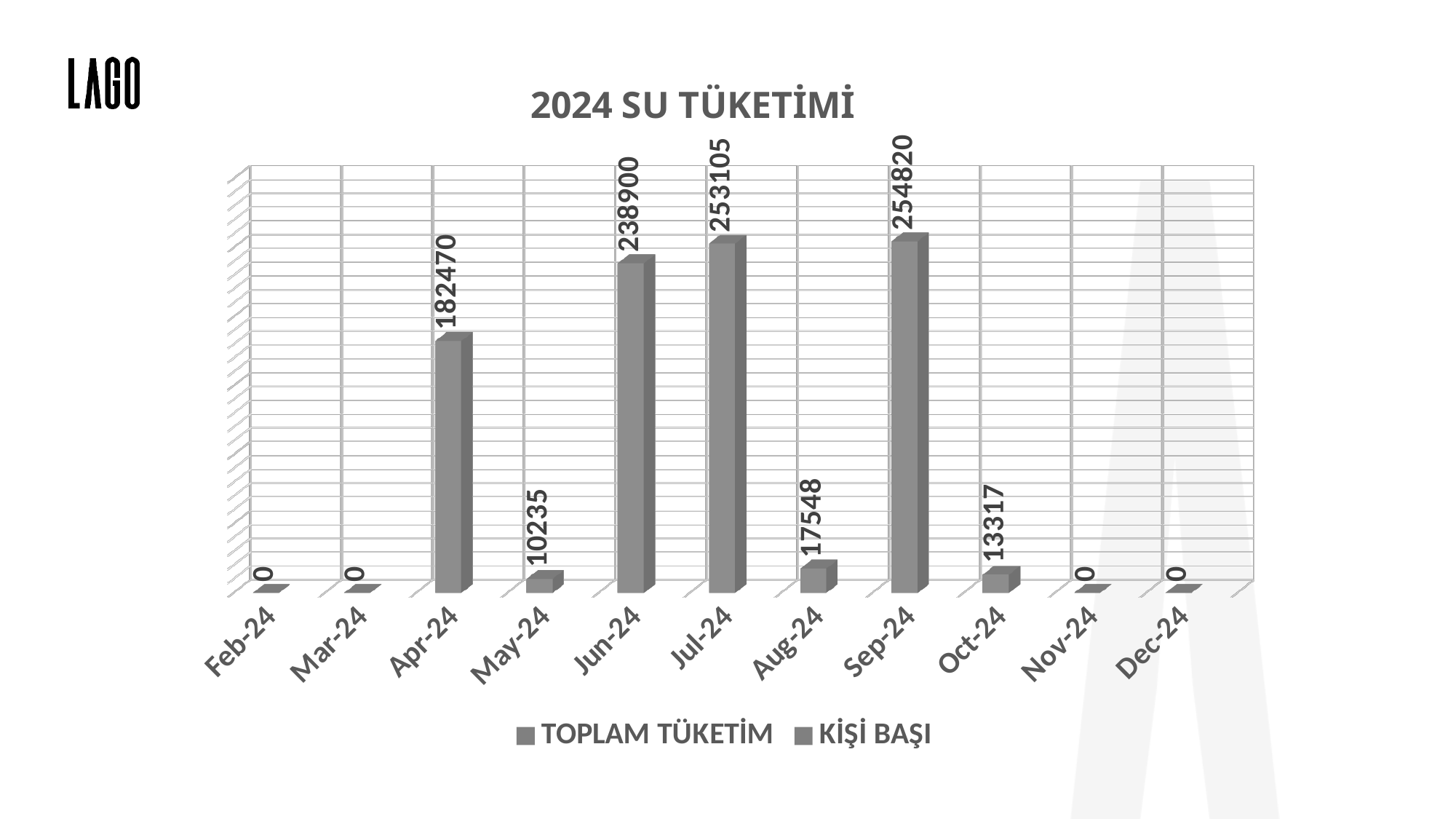
Which month has the highest labelled value in the 2024 SU TÜKETİMİ chart? Sep-24 Which is larger, the labelled value for Aug-24 or for Oct-24? Aug-24 How many months are shown on the x axis of the 2024 SU TÜKETİMİ chart? 11 What value is labelled for May-24 in the 2024 SU TÜKETİMİ chart? 10235 What is the difference between the labelled values for Sep-24 and Jul-24? 1715 What value is labelled for Oct-24 in the 2024 SU TÜKETİMİ chart? 13317 What value is labelled for Jul-24 in the 2024 SU TÜKETİMİ chart? 253105 What is the difference between the labelled values for Jun-24 and Apr-24? 56430 How many series does the legend of the 2024 SU TÜKETİMİ chart list? 2 What kind of chart is shown on the slide? Bar chart What are the two legend entries in the 2024 SU TÜKETİMİ chart? TOPLAM TÜKETİM and KİŞİ BAŞI What value is labelled for Apr-24 in the 2024 SU TÜKETİMİ chart? 182470